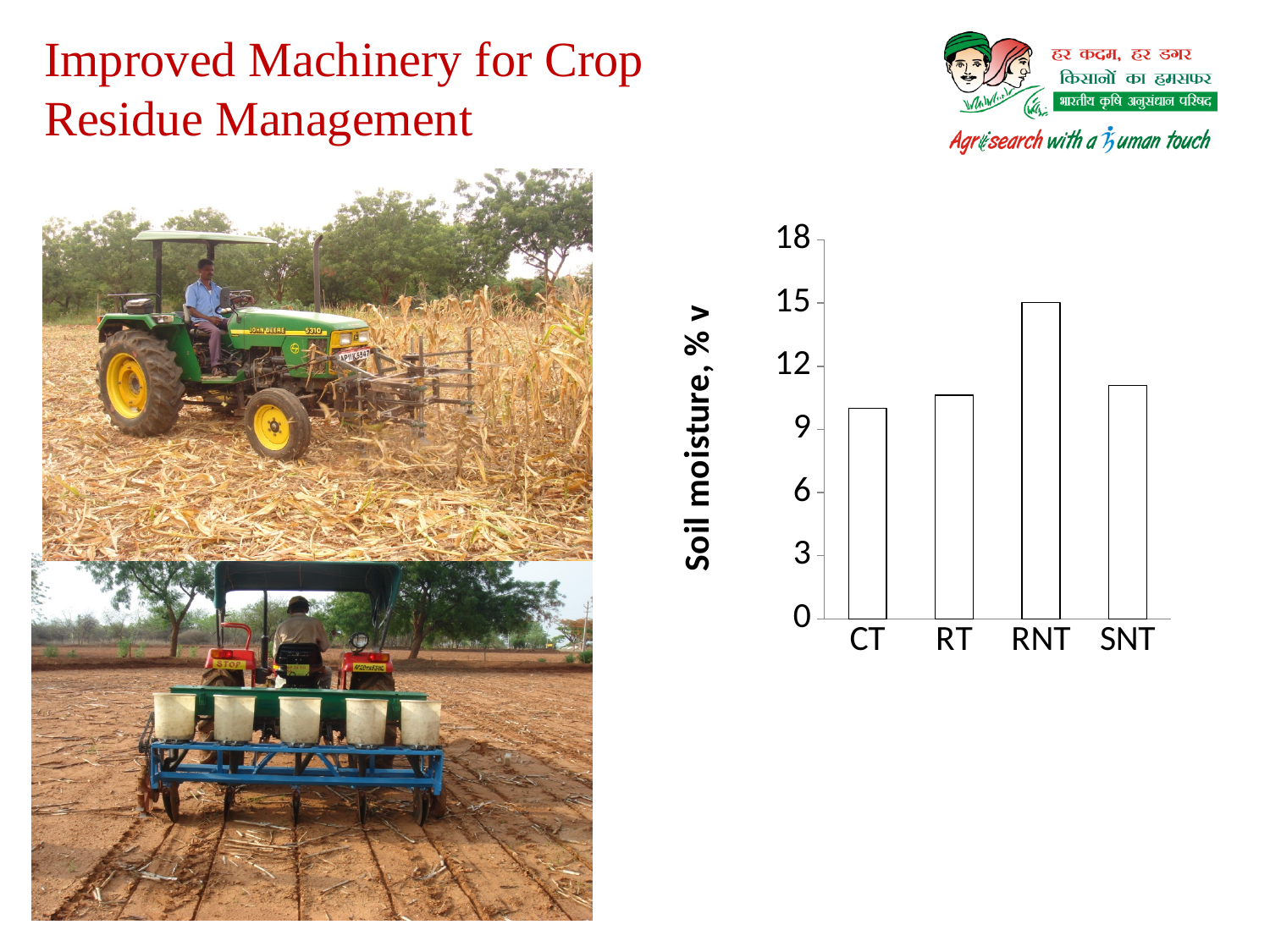
Is the soil moisture value for RNT greater or less than 12? greater Is the soil moisture value for SNT greater or less than 12? less What kind of chart is shown on the slide? bar chart Which has a higher soil moisture value, RNT or SNT? RNT What is the label of the y axis of the chart? Soil moisture, % v What is the soil moisture value for RNT? 15 What is the highest value shown on the y axis of the chart? 18 How many categories are shown on the x axis of the chart? 4 Which has a higher soil moisture value, CT or RNT? RNT Is the soil moisture value for CT greater or less than 12? less Which category has the highest soil moisture in the chart? RNT